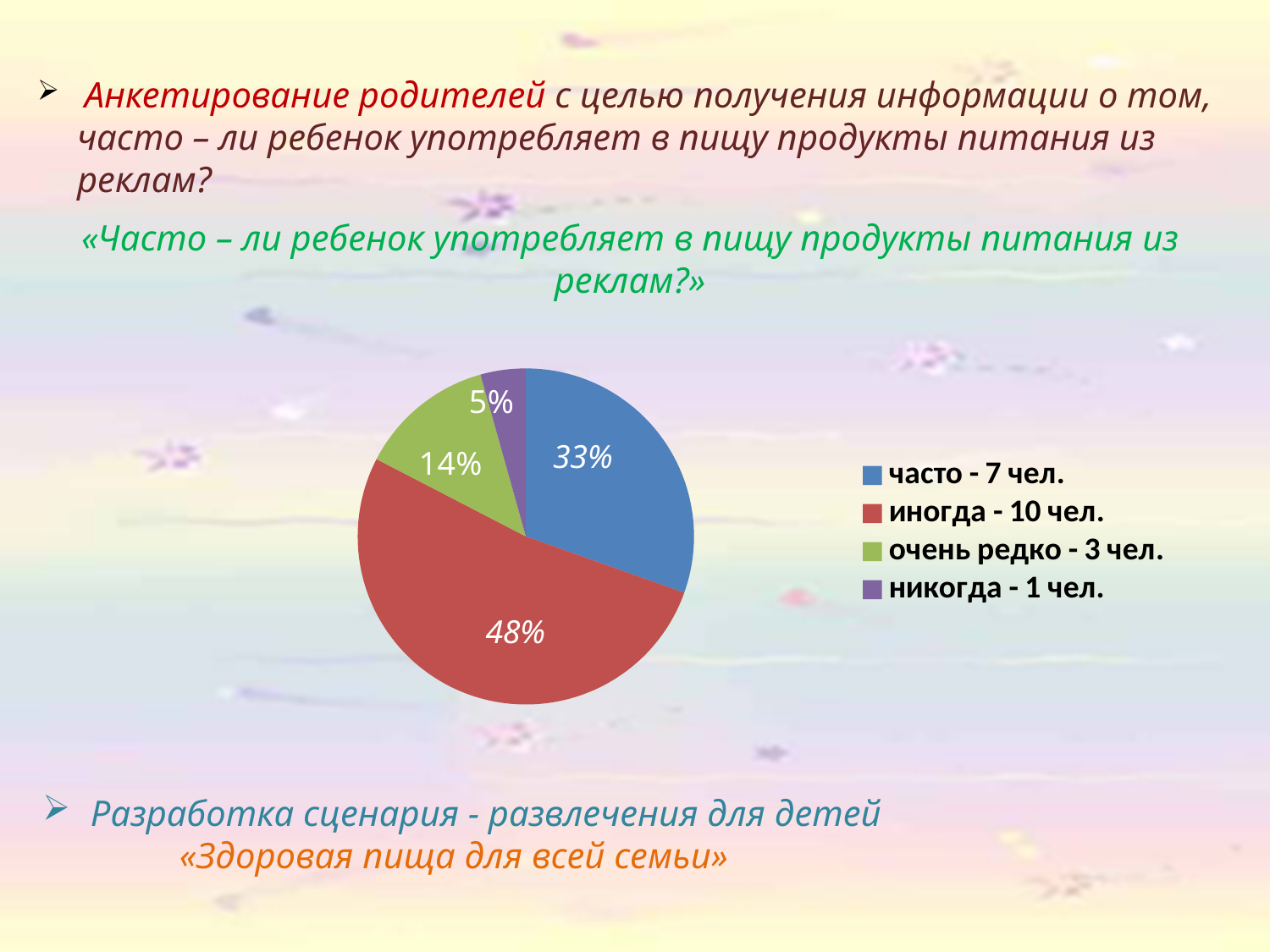
How many people answered "очень редко" according to the legend? 3 чел. What percentage of the pie is labelled for the "часто - 7 чел." slice? 33% What percentage of the pie is labelled for the "иногда - 10 чел." slice? 48% What colour is the "иногда - 10 чел." slice in the pie chart? red Which category has the smallest slice of the pie? никогда - 1 чел. What kind of chart is shown on the slide? pie chart What percentage of the pie is labelled for the "никогда - 1 чел." slice? 5% What percentage of the pie is labelled for the "очень редко - 3 чел." slice? 14% What is the difference in percentage points between the "иногда" slice and the "часто" slice? 15 Which slice is larger: "очень редко" or "никогда"? очень редко How many slices does the pie chart have? 4 Which category has the largest slice of the pie? иногда - 10 чел.